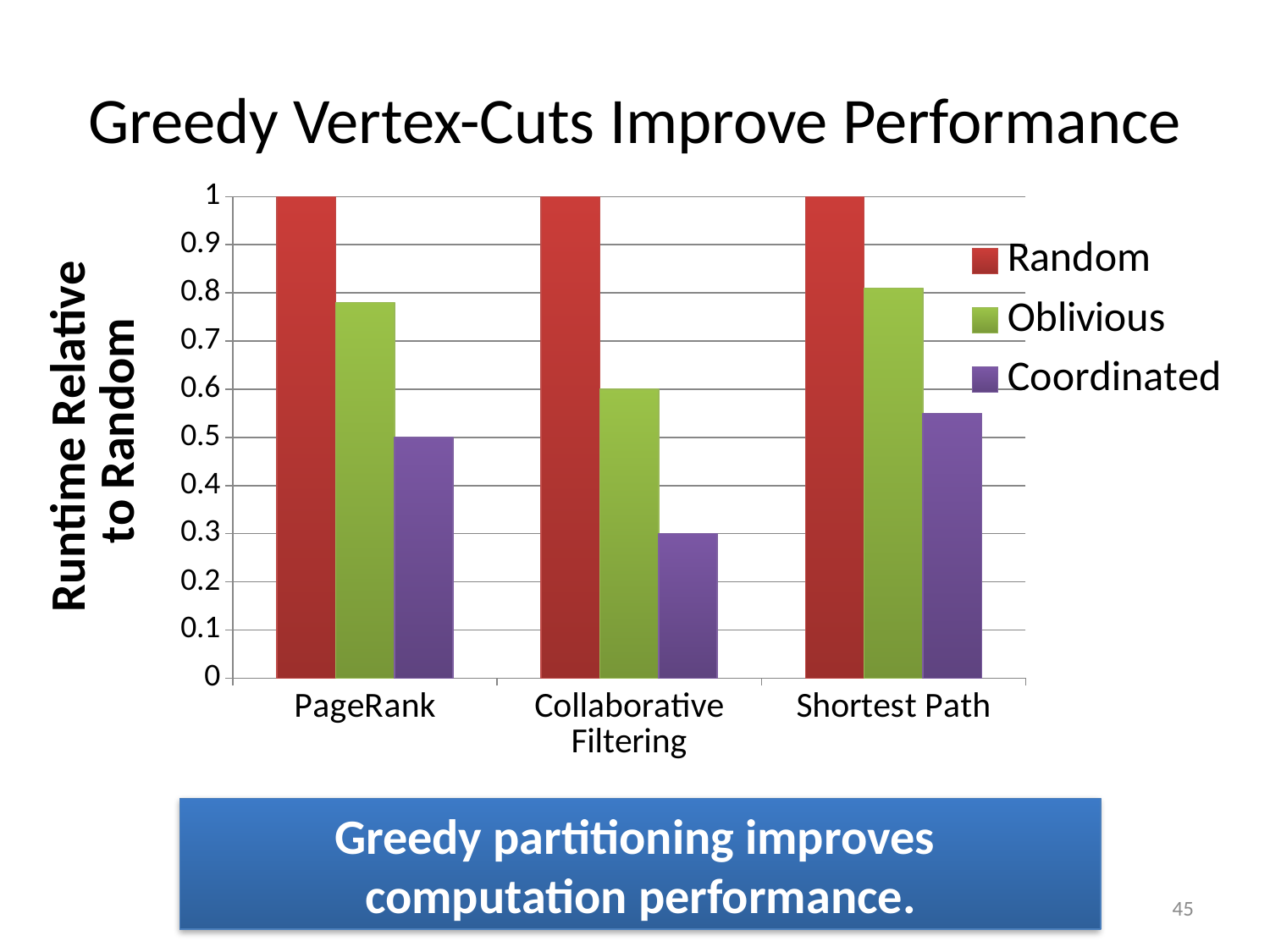
What type of chart is shown on the slide? bar chart What is the Random value for PageRank? 1 Is the Oblivious value for PageRank greater or less than 0.7? greater How many categories are shown on the x axis? 3 What is the difference between the Oblivious and Coordinated values for Collaborative Filtering? 0.3 Is the Coordinated value for Shortest Path greater or less than 0.6? less For which category is the Coordinated value lowest? Collaborative Filtering What is the Coordinated value for Collaborative Filtering? 0.3 What is the Coordinated value for PageRank? 0.5 What is the title of the y axis? Runtime Relative to Random What is the Oblivious value for Collaborative Filtering? 0.6 How many series does the legend list? 3